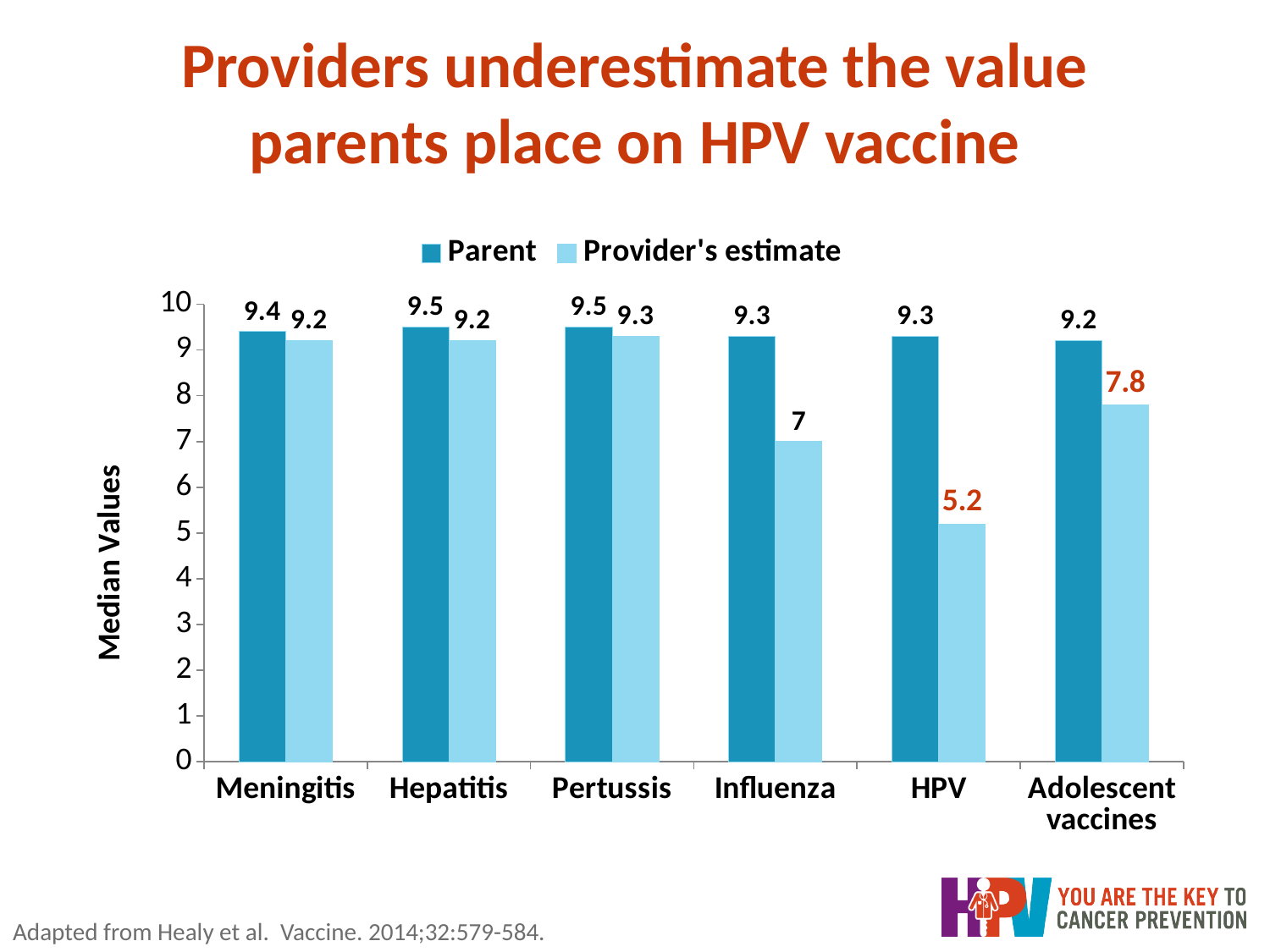
How many series does the legend list? 2 How many categories are shown on the x axis? 6 What is the Parent value for Meningitis? 9.4 What is the label on the vertical axis? Median Values Which category has the lowest Provider's estimate? HPV What is the difference between the Parent value and the Provider's estimate for HPV? 4.1 What is the Provider's estimate for Adolescent vaccines? 7.8 What kind of chart is shown on the slide? Bar chart Which is larger for Adolescent vaccines, the Parent value or the Provider's estimate? Parent What is the Provider's estimate for Influenza? 7 What is the difference between the Parent value and the Provider's estimate for Influenza? 2.3 What is the Provider's estimate for HPV? 5.2